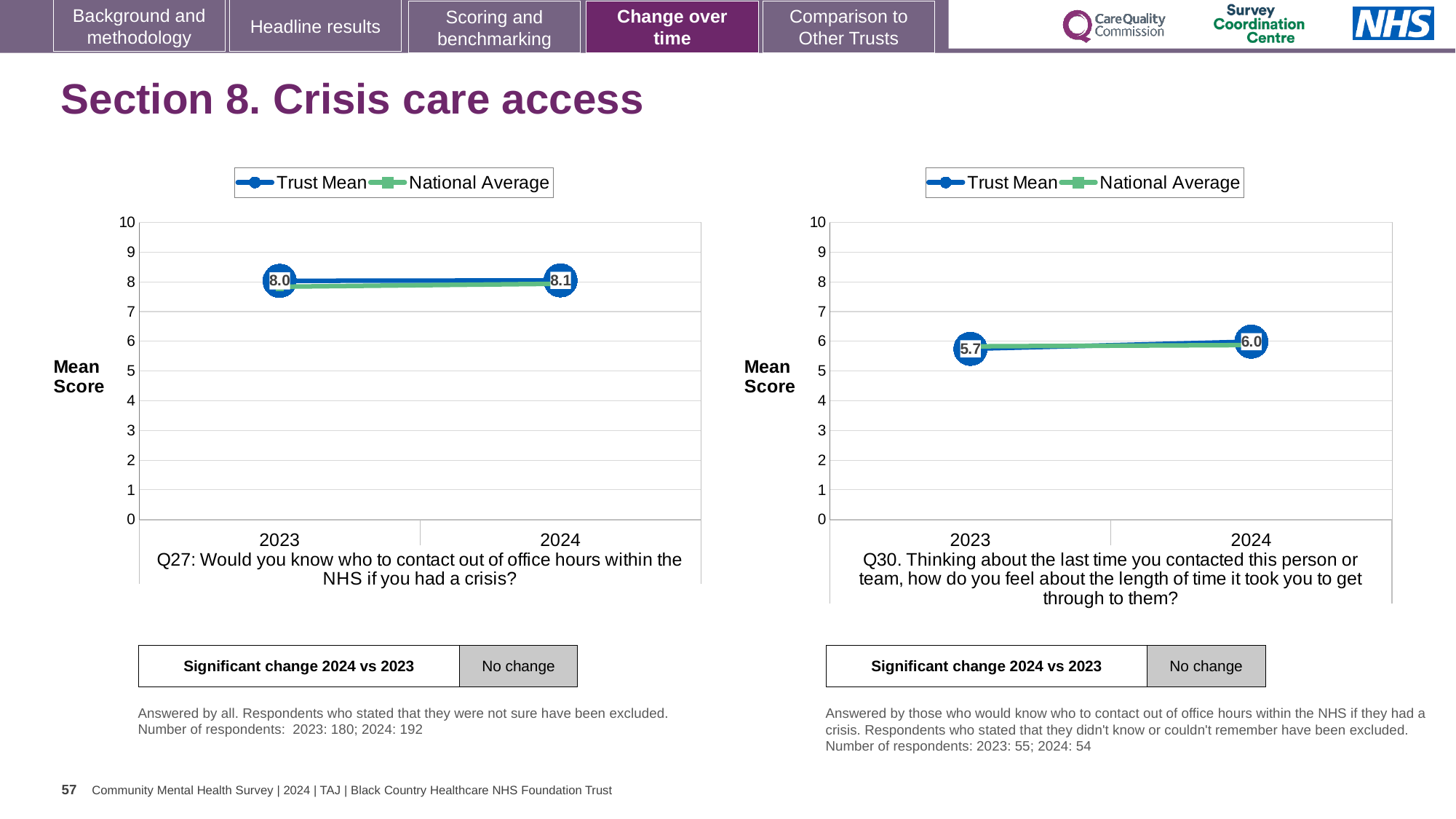
On the Q27 chart (left), what is the difference between the Trust Mean scores for 2024 and 2023? 0.1 On the Q27 chart (left), what is the Trust Mean score for 2023? 8.0 What kind of chart is the Q30 chart (right)? line chart On the Q30 chart (right), what is the difference between the Trust Mean scores for 2024 and 2023? 0.3 On the Q27 chart (left), is the Trust Mean for 2023 greater or less than 7? greater How many series does the legend of the Q27 chart (left) list? 2 On the Q30 chart (right), is the National Average for 2023 greater or less than 5? greater On the Q30 chart (right), what is the Trust Mean score for 2024? 6.0 On the Q27 chart (left), what is the Trust Mean score for 2024? 8.1 How many years are plotted on the x axis of the Q27 chart (left)? 2 On the Q30 chart (right), what is the Trust Mean score for 2023? 5.7 On the Q30 chart (right), does the Trust Mean rise or fall from 2023 to 2024? rise